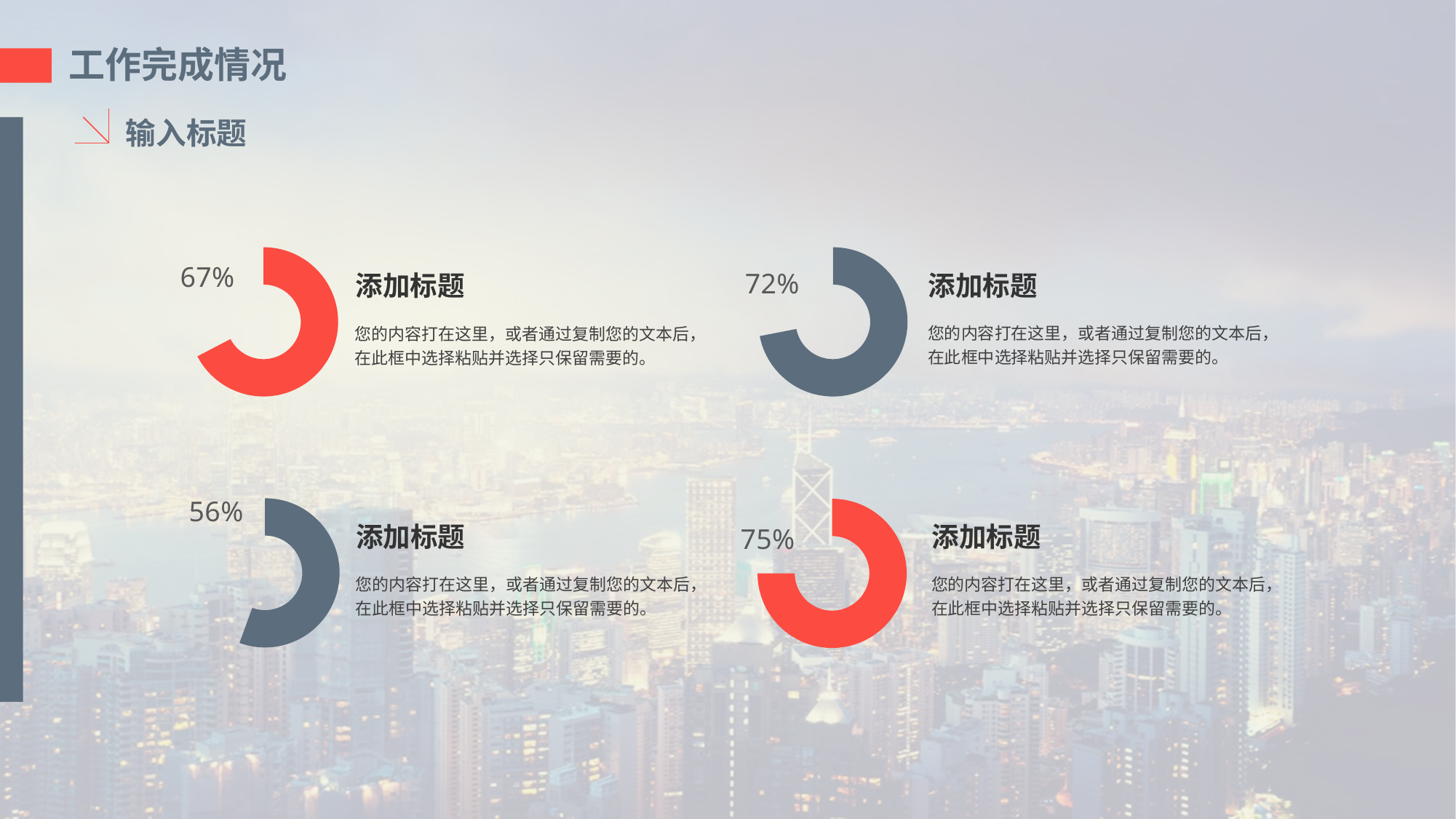
What is the difference between the percentage in the top-right chart and the percentage in the top-left chart? 5% What is the difference between the percentage in the bottom-right chart and the percentage in the bottom-left chart? 19% What kind of chart is used to show each percentage on the slide? Donut chart Which of the four donut charts shows the lowest percentage? The bottom-left chart (56%) What percentage is shown by the bottom-right donut chart? 75% Which is larger, the percentage in the top-left chart or the percentage in the top-right chart? The top-right chart (72%) Which of the four donut charts shows the highest percentage? The bottom-right chart (75%) What percentage is shown by the top-left donut chart? 67% What percentage is shown by the top-right donut chart? 72% How many donut charts are on the slide? 4 What colour is the filled portion of the top-left donut chart? Red What percentage is shown by the bottom-left donut chart? 56%